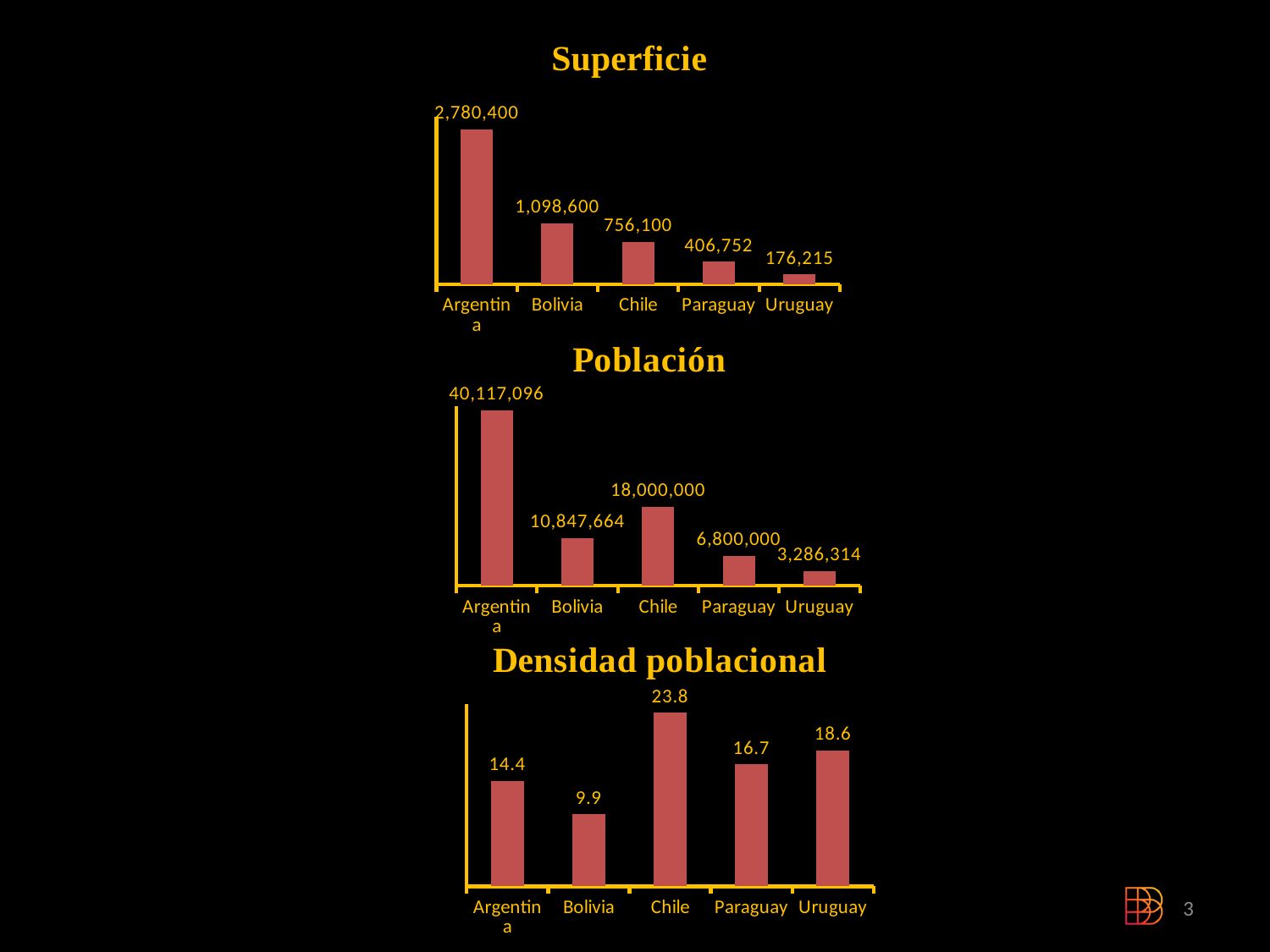
In the Población chart, which country has the highest value? Argentina In the Población chart, what is the difference between Chile and Bolivia? 7,152,336 What type of chart is the Superficie chart? Bar chart In the Densidad poblacional chart, which country has the highest value? Chile In the Superficie chart, what is the value for Chile? 756,100 In the Densidad poblacional chart, which country has the lowest value? Bolivia In the Densidad poblacional chart, which is larger, Paraguay or Argentina? Paraguay In the Población chart, what is the value for Paraguay? 6,800,000 In the Superficie chart, what is the difference between Argentina and Bolivia? 1,681,800 In the Superficie chart, which country has the lowest value? Uruguay How many countries are shown in the Población chart? 5 In the Densidad poblacional chart, what is the value for Uruguay? 18.6